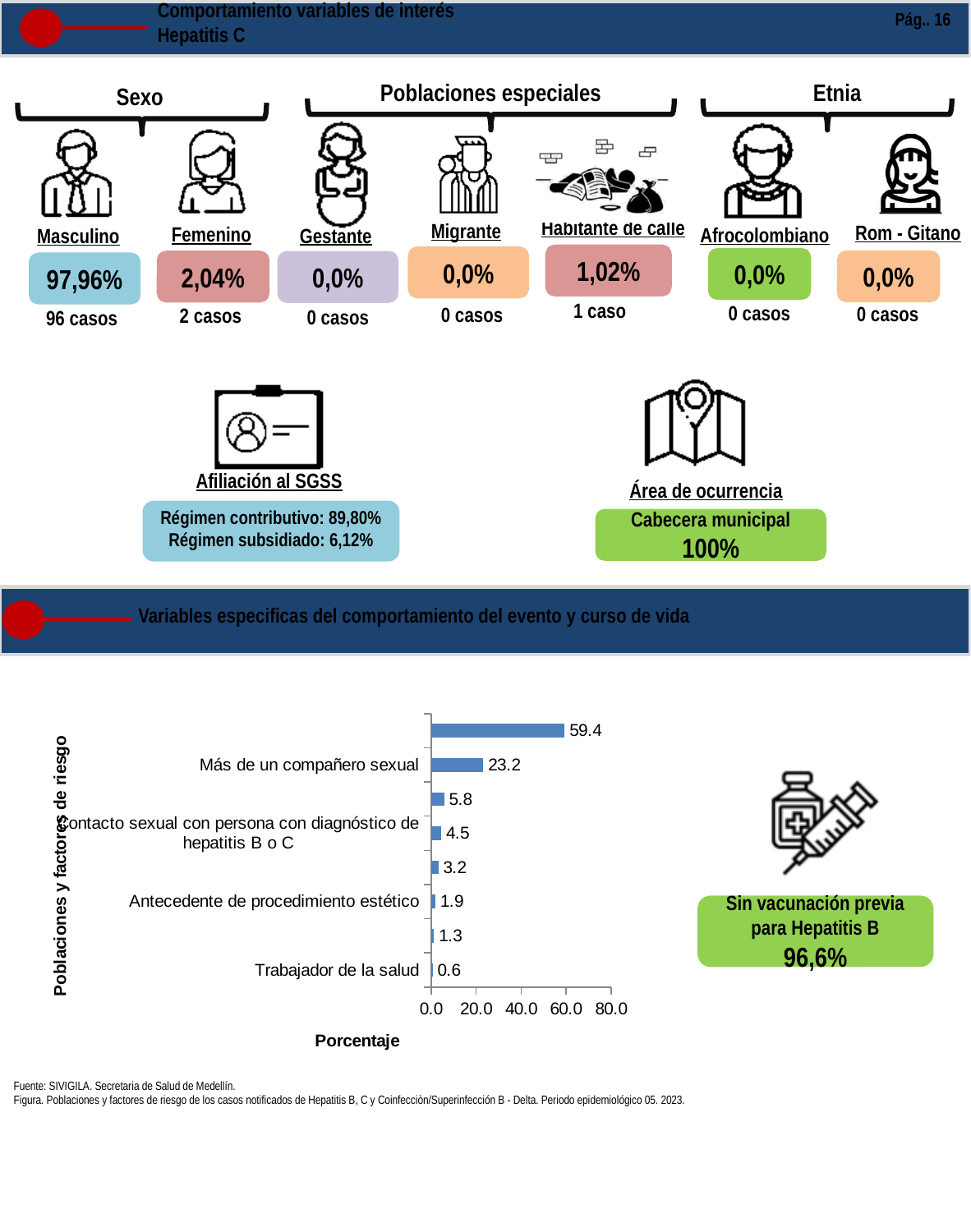
In the bar chart, which is larger: the value for 'Antecedente de procedimiento estético' or for 'Contacto sexual con persona con diagnóstico de hepatitis B o C'? Contacto sexual con persona con diagnóstico de hepatitis B o C In the bar chart, how many bars are plotted? 8 In the bar chart, which labeled category has the lowest value? Trabajador de la salud In the bar chart, what is the value for 'Más de un compañero sexual'? 23.2 In the bar chart, what is the value for 'Contacto sexual con persona con diagnóstico de hepatitis B o C'? 4.5 In the bar chart, what is the value for 'Trabajador de la salud'? 0.6 In the bar chart, is the value for 'Más de un compañero sexual' greater or less than 40.0? less What is the title of the horizontal axis of the bar chart? Porcentaje What type of chart is shown at the bottom of the slide? bar chart In the bar chart, what is the largest value shown on any bar? 59.4 In the bar chart, what is the value for 'Antecedente de procedimiento estético'? 1.9 In the bar chart, what is the difference between the values for 'Más de un compañero sexual' and 'Trabajador de la salud'? 22.6